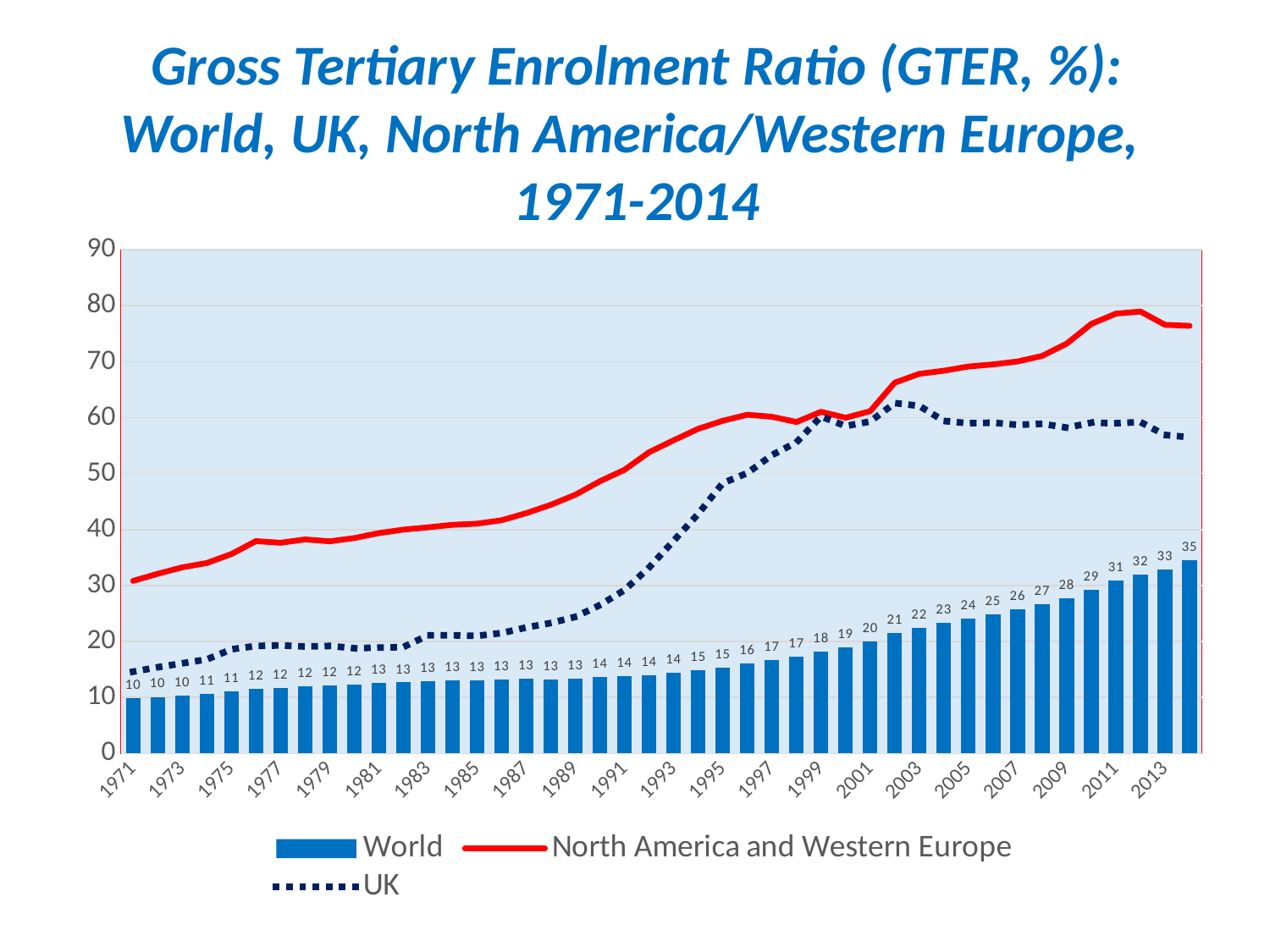
What is the World value for 1971? 10 What is the World value for 2013? 33 Do the World values rise or fall from 1971 to 2014? Rise What is the World value for 2001? 20 Which year has the highest World value? 2014 How many series does the legend list? 3 Which is larger, the World value for 2001 or for 1991? 2001 What is the lowest World value shown on the bars? 10 Is the value for North America and Western Europe in 2011 greater or less than 70? greater What is the difference between the World values for 2013 and 1971? 23 What kind of chart is this? Combined bar and line chart